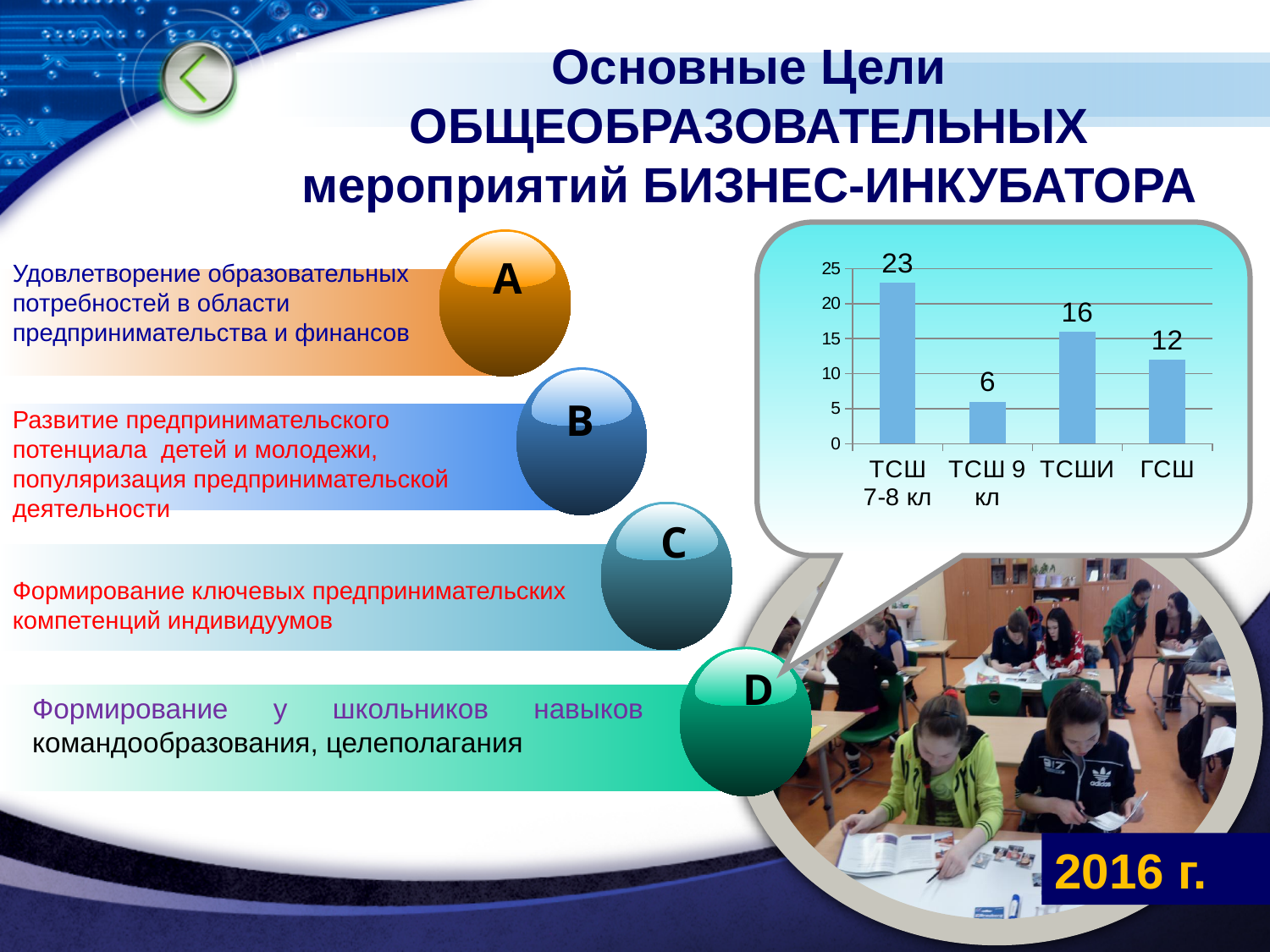
Which is larger, the value for ТСШИ or the value for ГСШ? ТСШИ What is the value for ГСШ? 12 Which category has the highest value? ТСШ 7-8 кл What is the difference between the values for ГСШ and ТСШ 9 кл? 6 How many categories are shown in the chart? 4 What is the total of all four values in the chart? 57 Which category has the lowest value? ТСШ 9 кл What is the value for ТСШИ? 16 What is the difference between the values for ТСШ 7-8 кл and ТСШИ? 7 What is the value for ТСШ 7-8 кл? 23 What is the value for ТСШ 9 кл? 6 What kind of chart is shown on the slide? bar chart